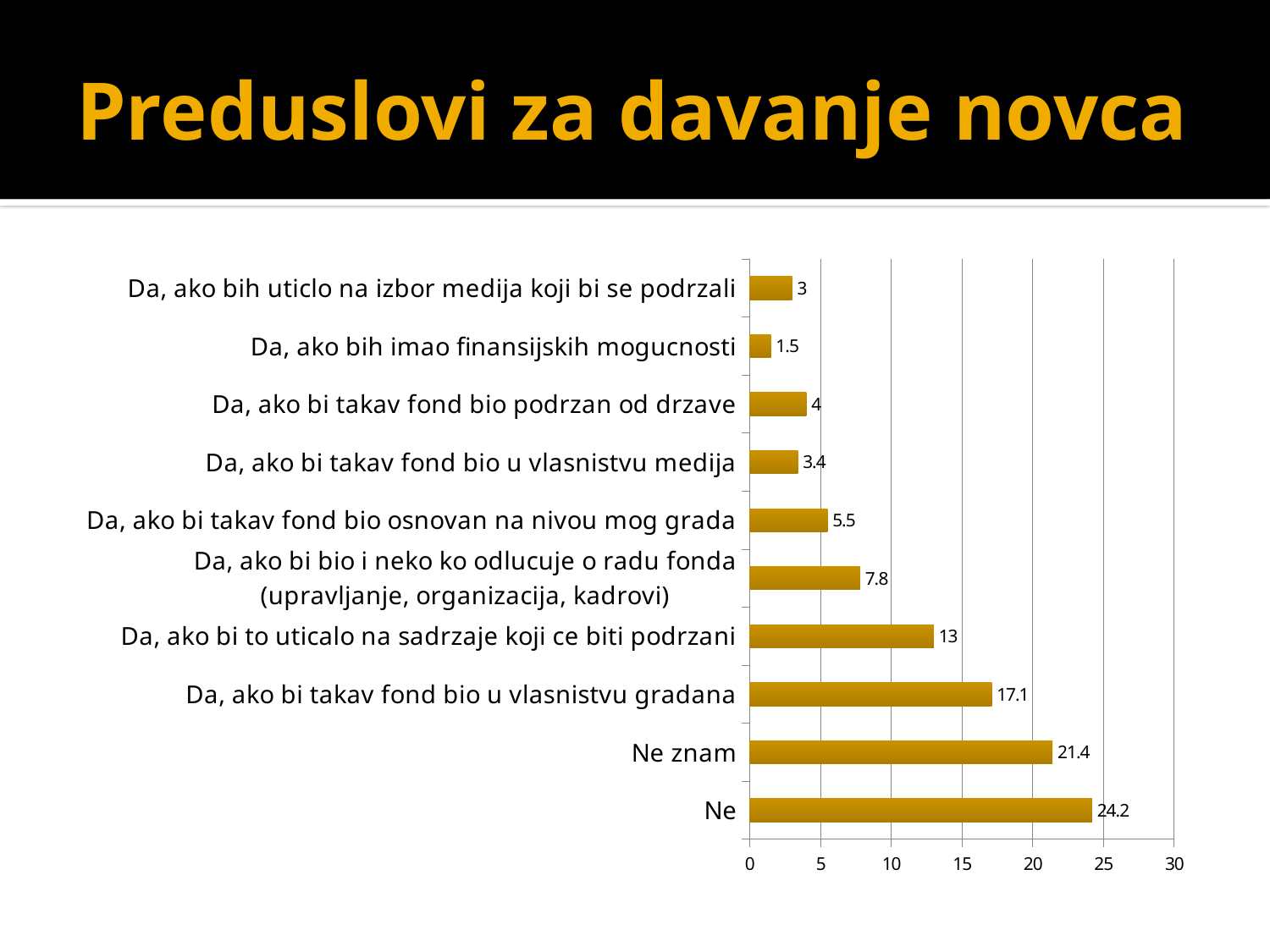
Which category has the lowest value? Da, ako bih imao finansijskih mogucnosti Which category has the highest value? Ne How many categories are shown in the chart? 10 What is the value for "Da, ako bi takav fond bio u vlasnistvu gradana"? 17.1 What is the value for "Da, ako bih imao finansijskih mogucnosti"? 1.5 What is the value for "Ne znam"? 21.4 Is the value for "Da, ako bi takav fond bio u vlasnistvu gradana" greater or less than 15? greater What is the value for "Ne"? 24.2 What is the title of the slide? Preduslovi za davanje novca Which is larger: the value for "Da, ako bi to uticalo na sadrzaje koji ce biti podrzani" or for "Da, ako bi bio i neko ko odlucuje o radu fonda (upravljanje, organizacija, kadrovi)"? Da, ako bi to uticalo na sadrzaje koji ce biti podrzani What is the difference between the values for "Ne" and "Ne znam"? 2.8 What kind of chart is shown on the slide? bar chart